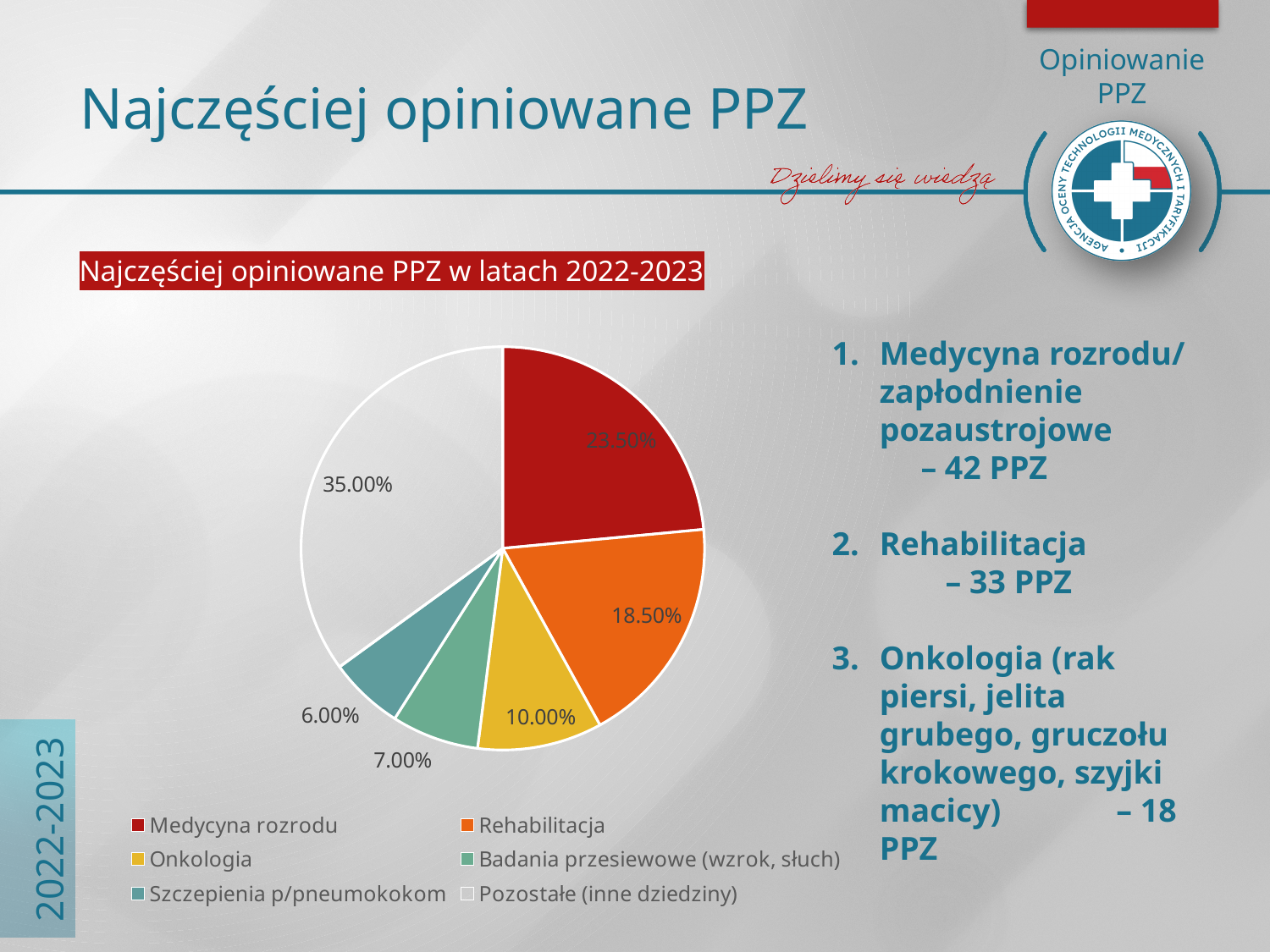
Which category has the smallest slice of the pie? Szczepienia p/pneumokokom What kind of chart is shown on the slide? pie chart How many slices does the pie chart have? 6 What percentage of the pie is Onkologia? 10.00% Which category has the largest slice of the pie? Pozostałe (inne dziedziny) What percentage of the pie is Medycyna rozrodu? 23.50% What percentage of the pie is Rehabilitacja? 18.50% Which is larger, the slice for Onkologia or the slice for Badania przesiewowe (wzrok, słuch)? Onkologia What is the difference in percentage points between Medycyna rozrodu and Rehabilitacja? 5 percentage points What colour is the slice for Rehabilitacja? orange What percentage of the pie is Pozostałe (inne dziedziny)? 35.00% What percentage of the pie is Szczepienia p/pneumokokom? 6.00%